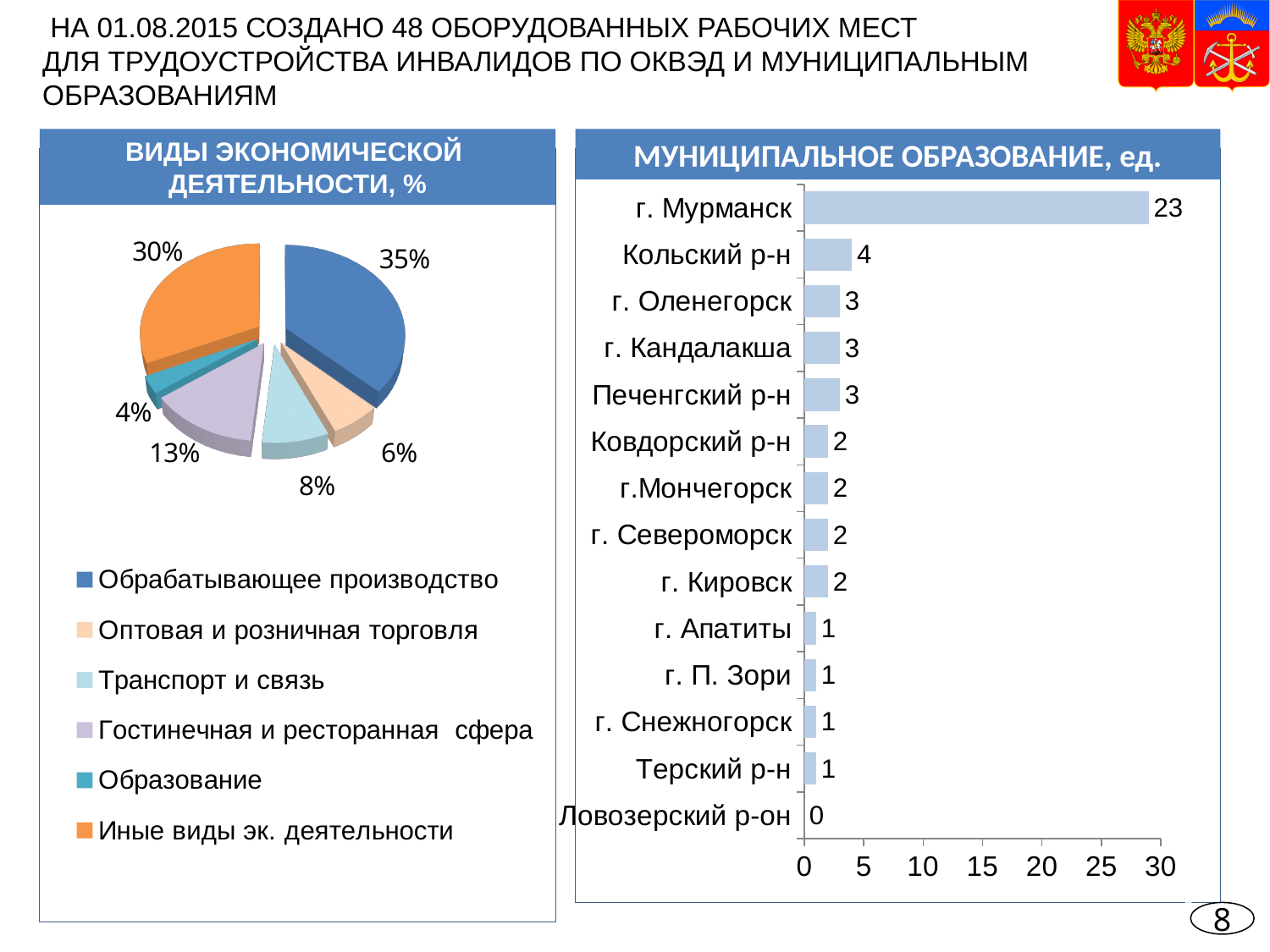
On the chart titled 'МУНИЦИПАЛЬНОЕ ОБРАЗОВАНИЕ, ед.', how many municipalities are listed? 14 On the chart titled 'МУНИЦИПАЛЬНОЕ ОБРАЗОВАНИЕ, ед.', which is larger: the value for г. Оленегорск or the value for г. Апатиты? г. Оленегорск What kind of chart is the one titled 'МУНИЦИПАЛЬНОЕ ОБРАЗОВАНИЕ, ед.'? bar chart On the pie chart titled 'ВИДЫ ЭКОНОМИЧЕСКОЙ ДЕЯТЕЛЬНОСТИ, %', what share does Образование have? 4% On the chart titled 'МУНИЦИПАЛЬНОЕ ОБРАЗОВАНИЕ, ед.', what is the difference between the values for г. Мурманск and Кольский р-н? 19 On the chart titled 'МУНИЦИПАЛЬНОЕ ОБРАЗОВАНИЕ, ед.', what is the value for Кольский р-н? 4 How many entries does the legend of the pie chart titled 'ВИДЫ ЭКОНОМИЧЕСКОЙ ДЕЯТЕЛЬНОСТИ, %' list? 6 On the chart titled 'МУНИЦИПАЛЬНОЕ ОБРАЗОВАНИЕ, ед.', which municipality has the lowest value? Ловозерский р-он On the chart titled 'МУНИЦИПАЛЬНОЕ ОБРАЗОВАНИЕ, ед.', what is the value for г. Мурманск? 23 On the pie chart titled 'ВИДЫ ЭКОНОМИЧЕСКОЙ ДЕЯТЕЛЬНОСТИ, %', which category has the largest slice? Обрабатывающее производство On the pie chart titled 'ВИДЫ ЭКОНОМИЧЕСКОЙ ДЕЯТЕЛЬНОСТИ, %', what share does Обрабатывающее производство have? 35% On the chart titled 'МУНИЦИПАЛЬНОЕ ОБРАЗОВАНИЕ, ед.', which municipality has the highest value? г. Мурманск